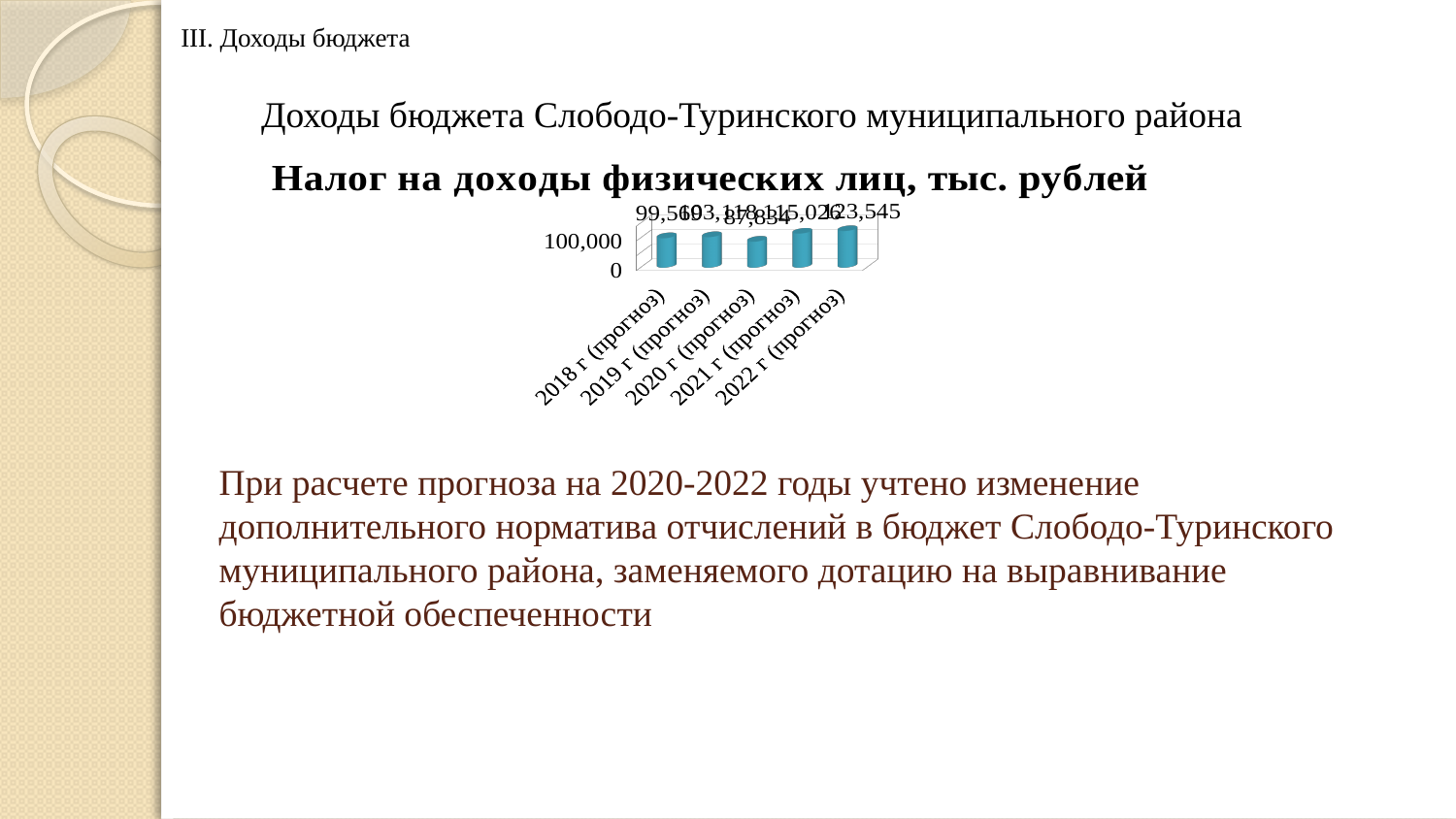
Which year has the lowest value in the chart? 2020 г (прогноз) How many categories (years) are plotted in the chart? 5 What is the value for 2020 г (прогноз)? 87,834 Is the value for 2020 г (прогноз) greater or less than 100,000? less What is the value for 2022 г (прогноз)? 123,545 What kind of chart is shown on the slide? bar chart What is the highest tick label shown on the vertical axis of the chart? 100,000 Which is larger, the value for 2022 г (прогноз) or the value for 2020 г (прогноз)? 2022 г (прогноз) What is the difference between the values for 2022 г (прогноз) and 2020 г (прогноз)? 35,711 Which year has the highest value in the chart? 2022 г (прогноз) What is the title of the chart? Налог на доходы физических лиц, тыс. рублей Is the value for 2022 г (прогноз) greater or less than 100,000? greater